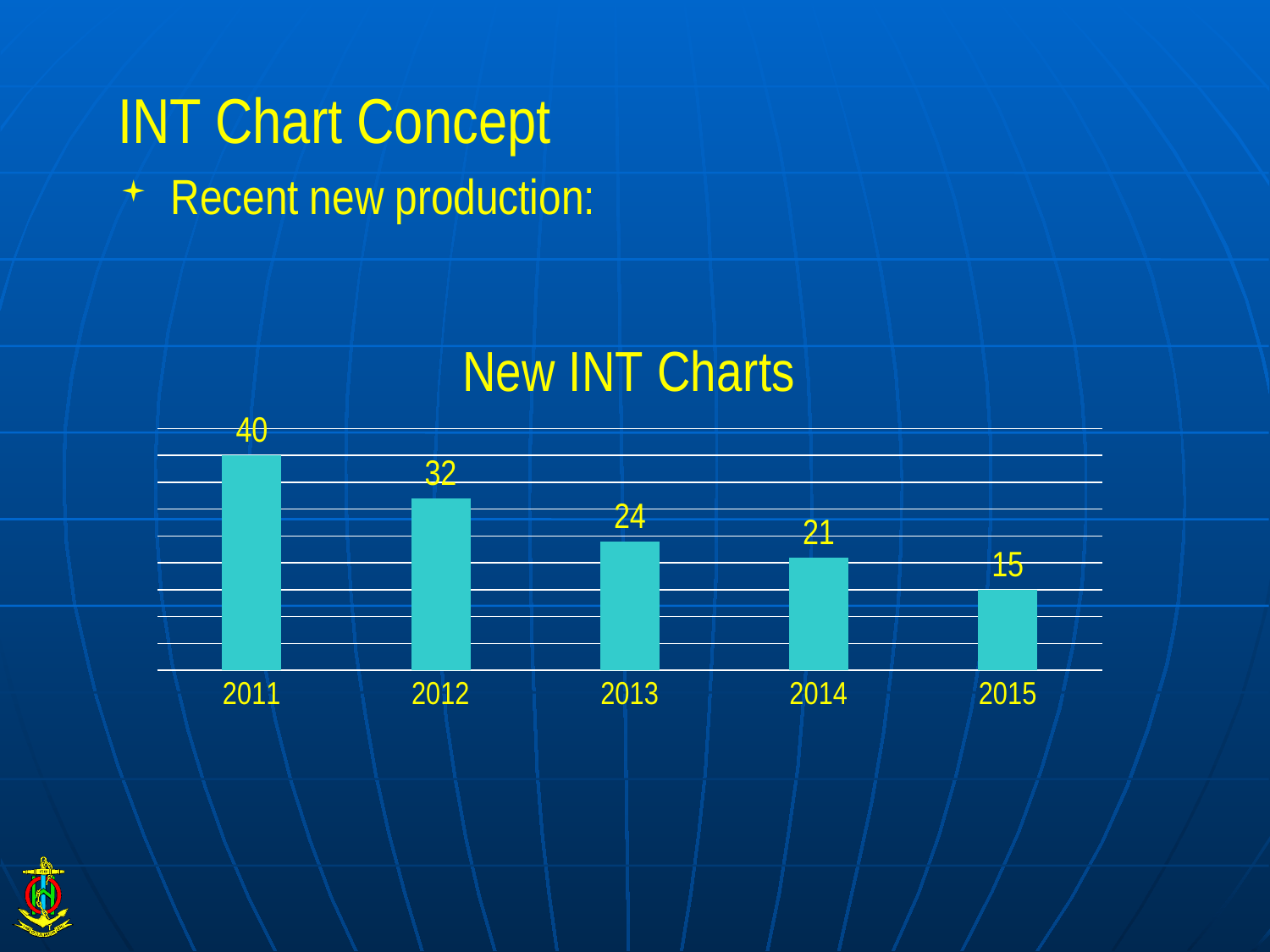
What is the value for 2013 in the New INT Charts chart? 24 What is the value for 2015 in the New INT Charts chart? 15 Which year has the highest value in the New INT Charts chart? 2011 What is the title of the chart? New INT Charts What is the value for 2011 in the New INT Charts chart? 40 What kind of chart is shown on the slide? bar chart How many years are shown on the x axis of the chart? 5 Do the values rise or fall from 2011 to 2015? fall What is the difference between the values for 2014 and 2015? 6 Which is larger, the value for 2012 or the value for 2014? 2012 What is the difference between the values for 2011 and 2012? 8 Which year has the lowest value in the New INT Charts chart? 2015